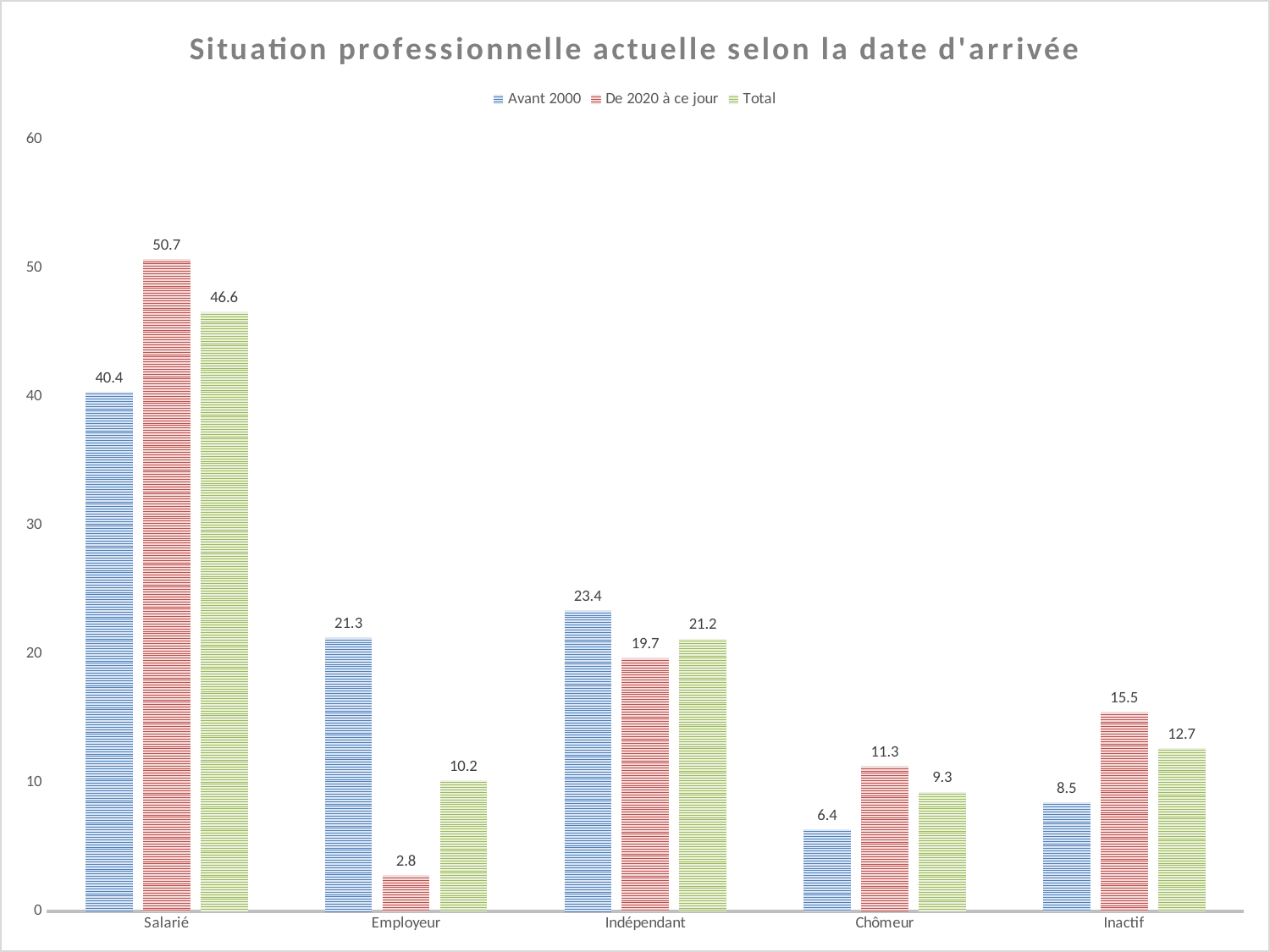
What is the title of the chart? Situation professionnelle actuelle selon la date d'arrivée What kind of chart is shown on the slide? bar chart Which category has the highest value in the De 2020 à ce jour series? Salarié How many series does the legend list? 3 Is the Total value for Salarié greater or less than 40? greater How many categories are shown on the x axis? 5 What is the difference between the De 2020 à ce jour and Avant 2000 values for Salarié? 10.3 What is the Total value for Inactif? 12.7 What is the value for Employeur in the De 2020 à ce jour series? 2.8 For Indépendant, which is larger: the Avant 2000 value or the De 2020 à ce jour value? Avant 2000 What is the value for Salarié in the Avant 2000 series? 40.4 Which category has the lowest value in the Avant 2000 series? Chômeur